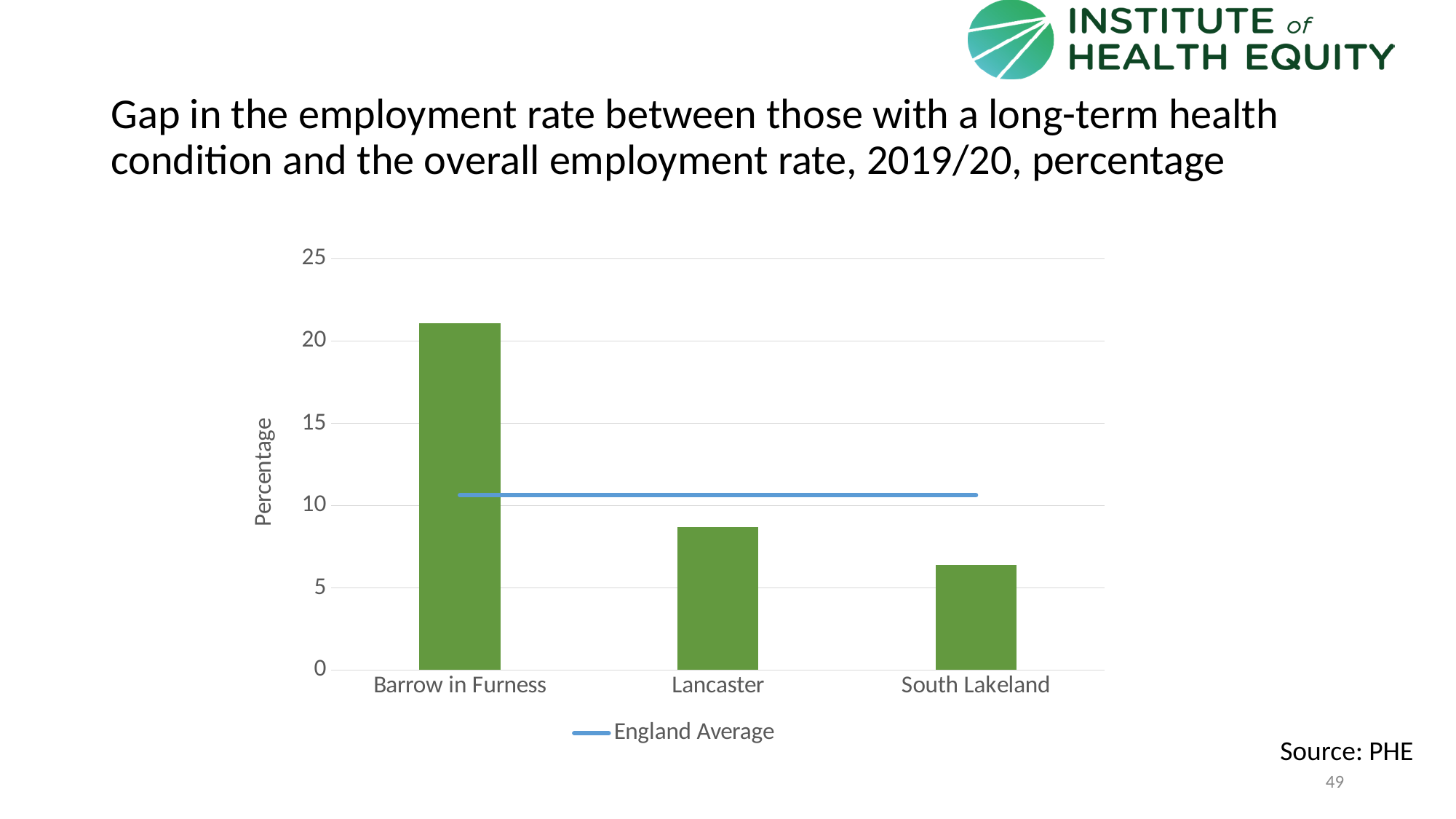
What is the label on the vertical axis of the chart? Percentage What kind of chart is shown on the slide? bar and line chart Is the value for Lancaster greater or less than 10? less How many areas are shown on the x axis of the chart? 3 Which area has the lowest gap in the employment rate? South Lakeland Do the bar values rise or fall from left to right across the x axis? fall Is the England Average line greater or less than 10? greater How many entries does the chart legend list? 1 Is the value for South Lakeland greater or less than 5? greater Which area has the highest gap in the employment rate? Barrow in Furness Which is larger, the value for Lancaster or the value for South Lakeland? Lancaster